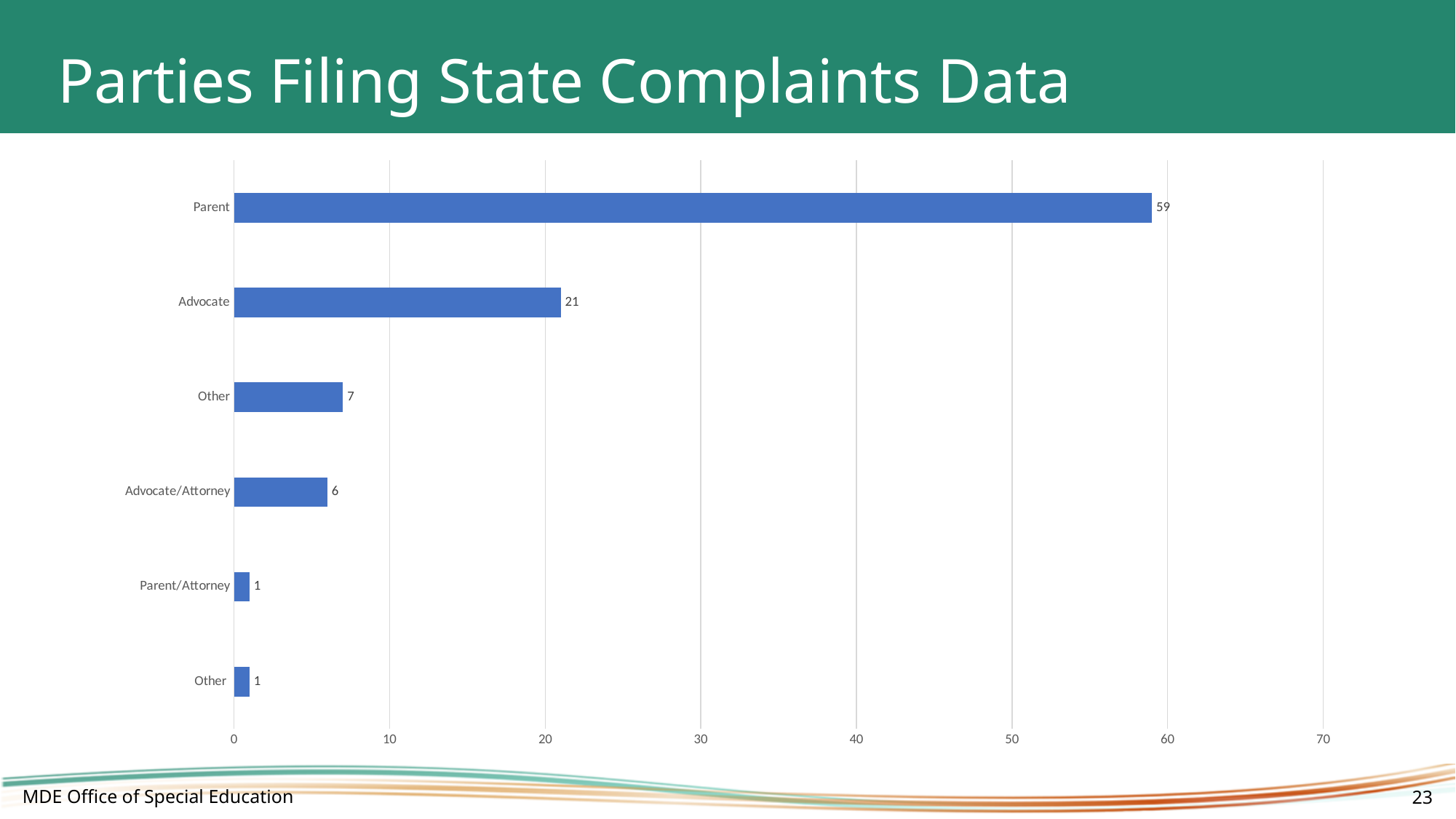
What is the value for Advocate/Attorney? 6 Which is larger, the value for Advocate or the value for Advocate/Attorney? Advocate What is the value for Parent? 59 What is the value for Advocate? 21 What is the difference between the values for Parent and Advocate? 38 What is the title of the slide containing the chart? Parties Filing State Complaints Data What is the lowest value shown on the chart? 1 What kind of chart is shown on the slide? Bar chart What is the value for Parent/Attorney? 1 How many bars are shown on the chart? 6 Is the value for Parent greater or less than 50? greater Which category has the highest value? Parent